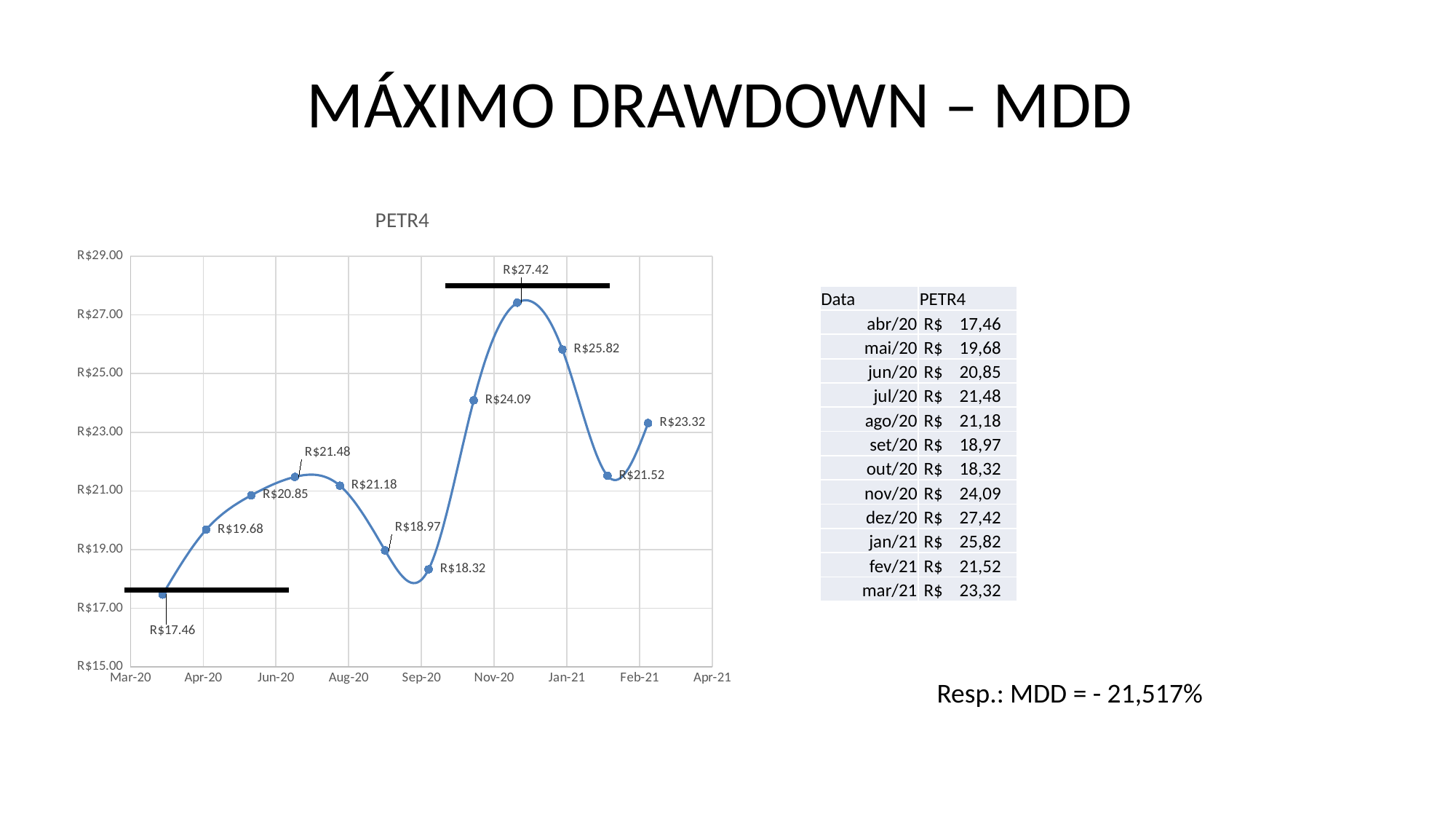
What is the difference between the Dec-20 value (R$27.42) and the Oct-20 value (R$18.32)? R$9.10 What is the lowest value plotted on the PETR4 chart? R$17.46 What is the highest value plotted on the PETR4 chart? R$27.42 Which is larger, the value for Jan-21 or the value for Nov-20? Jan-21 What is the title of the chart? PETR4 What is the PETR4 value for Nov-20? R$24.09 Is the value for Mar-21 greater or less than R$23.00? greater How many data points are plotted on the PETR4 line? 12 What is the PETR4 value for Feb-21? R$21.52 What is the difference between the highest value (R$27.42) and the lowest value (R$17.46) on the chart? R$9.96 Do the values rise or fall from Dec-20 to Feb-21? fall What kind of chart is shown on the slide? line chart